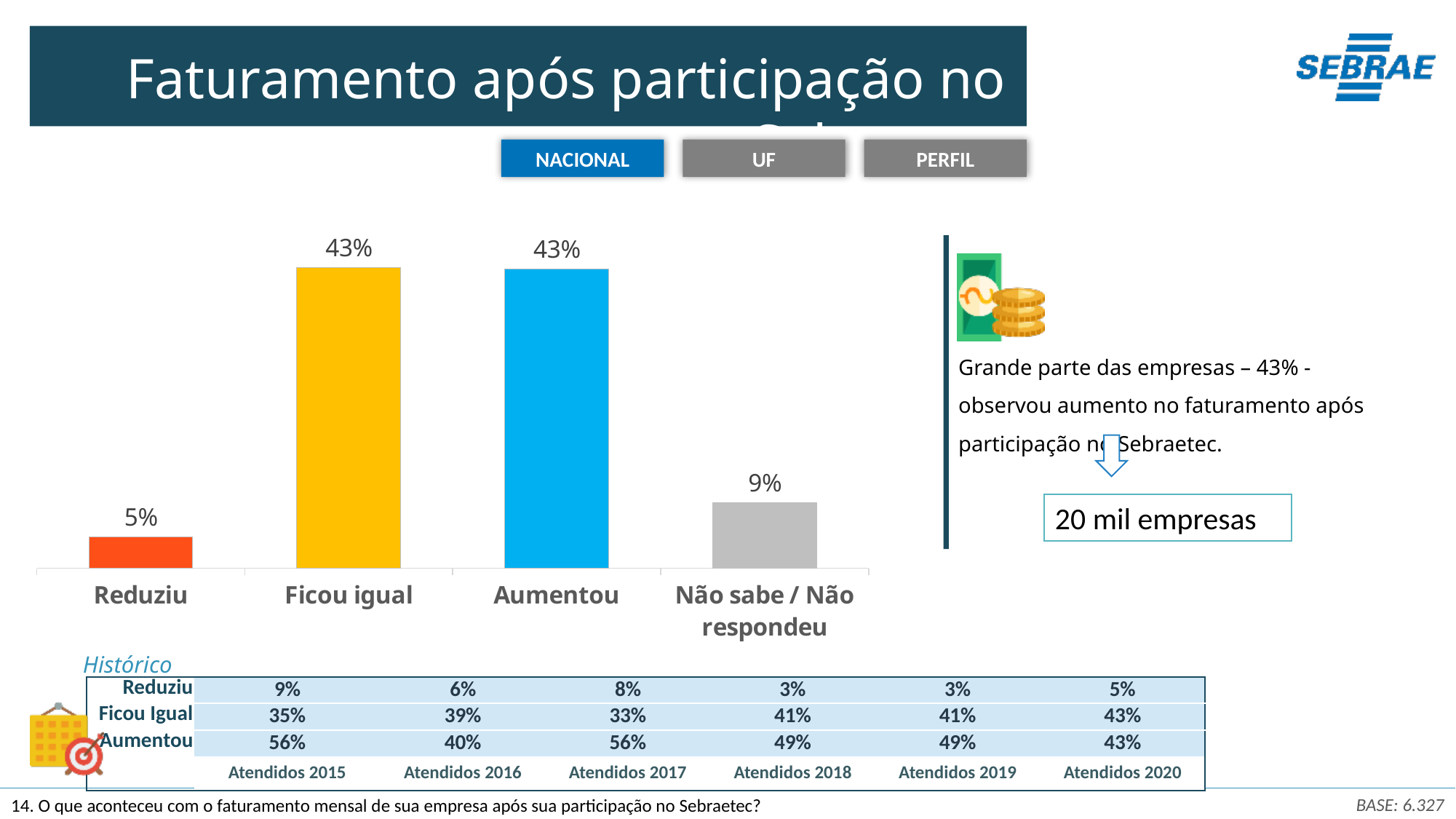
What is the value shown for 'Ficou igual'? 43% What is the difference between the values for 'Aumentou' and 'Reduziu'? 38% What is the value shown for 'Aumentou'? 43% Which is larger, the value for 'Não sabe / Não respondeu' or the value for 'Reduziu'? Não sabe / Não respondeu What is the difference between 'Não sabe / Não respondeu' and 'Reduziu'? 4% What percentage is shown for 'Não sabe / Não respondeu'? 9% What type of chart is shown on the slide? Bar chart Which is larger, the value for 'Ficou igual' or the value for 'Não sabe / Não respondeu'? Ficou igual What percentage of companies reported that revenue 'Reduziu'? 5% What colour is the bar for 'Aumentou'? Blue Which category has the lowest value in the bar chart? Reduziu How many categories are shown in the bar chart? 4